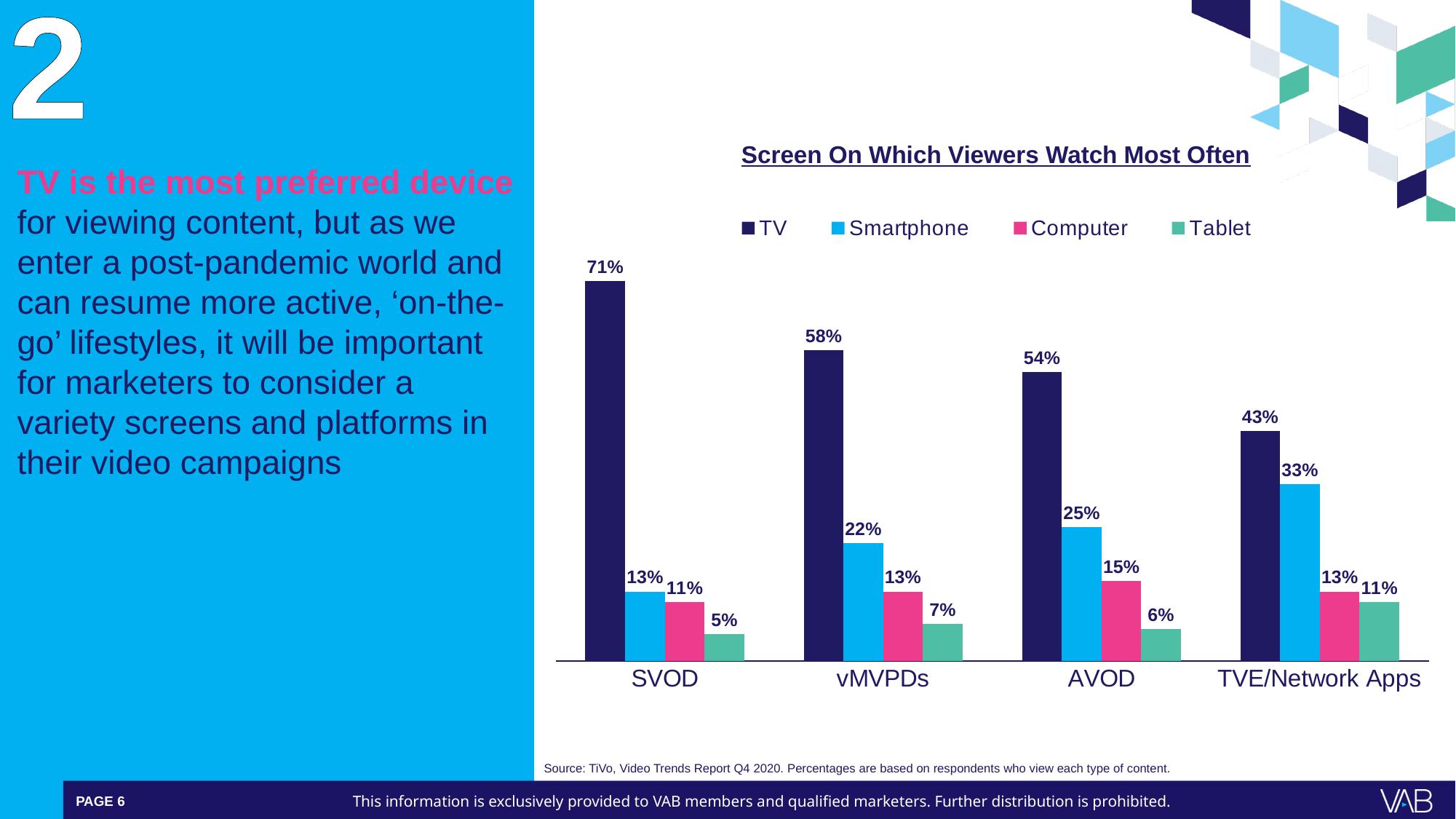
How many categories are shown on the x axis? 4 What is the Smartphone value for TVE/Network Apps? 33% What kind of chart is shown? Bar chart What is the difference between the TV and Smartphone values for AVOD? 29% Which category has the lowest Tablet value? SVOD What is the Computer value for vMVPDs? 13% Which category has the highest TV value? SVOD What is the Tablet value for AVOD? 6% What is the title of the chart? Screen On Which Viewers Watch Most Often What is the TV value for SVOD? 71% How many series does the legend list? 4 Which is larger, the Smartphone value for vMVPDs or the Smartphone value for AVOD? AVOD